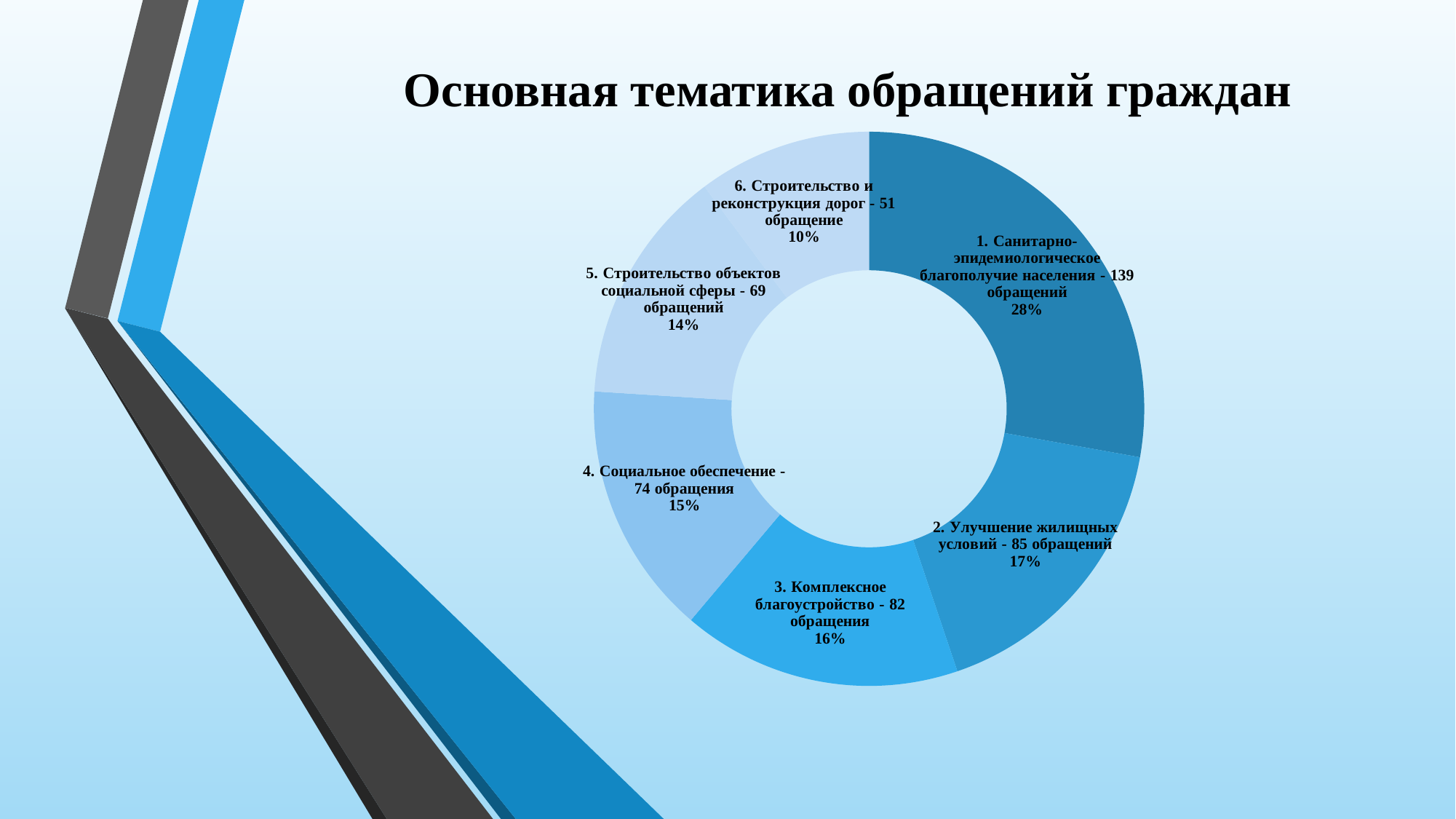
How many categories does the chart show? 6 What percentage share does "Улучшение жилищных условий" have? 17% Which has more обращений: "Строительство объектов социальной сферы" or "Строительство и реконструкция дорог"? Строительство объектов социальной сферы How many обращений are shown for "Комплексное благоустройство"? 82 What percentage share does "Социальное обеспечение" have? 15% What is the title of the chart? Основная тематика обращений граждан Which category has the smallest share of the chart? Строительство и реконструкция дорог What type of chart is shown on the slide? Doughnut chart How many обращений are shown for "Санитарно-эпидемиологическое благополучие населения"? 139 Which category has the largest share of the chart? Санитарно-эпидемиологическое благополучие населения What is the difference in the number of обращений between "Социальное обеспечение" and "Строительство объектов социальной сферы"? 5 What is the difference in the number of обращений between "Санитарно-эпидемиологическое благополучие населения" and "Улучшение жилищных условий"? 54